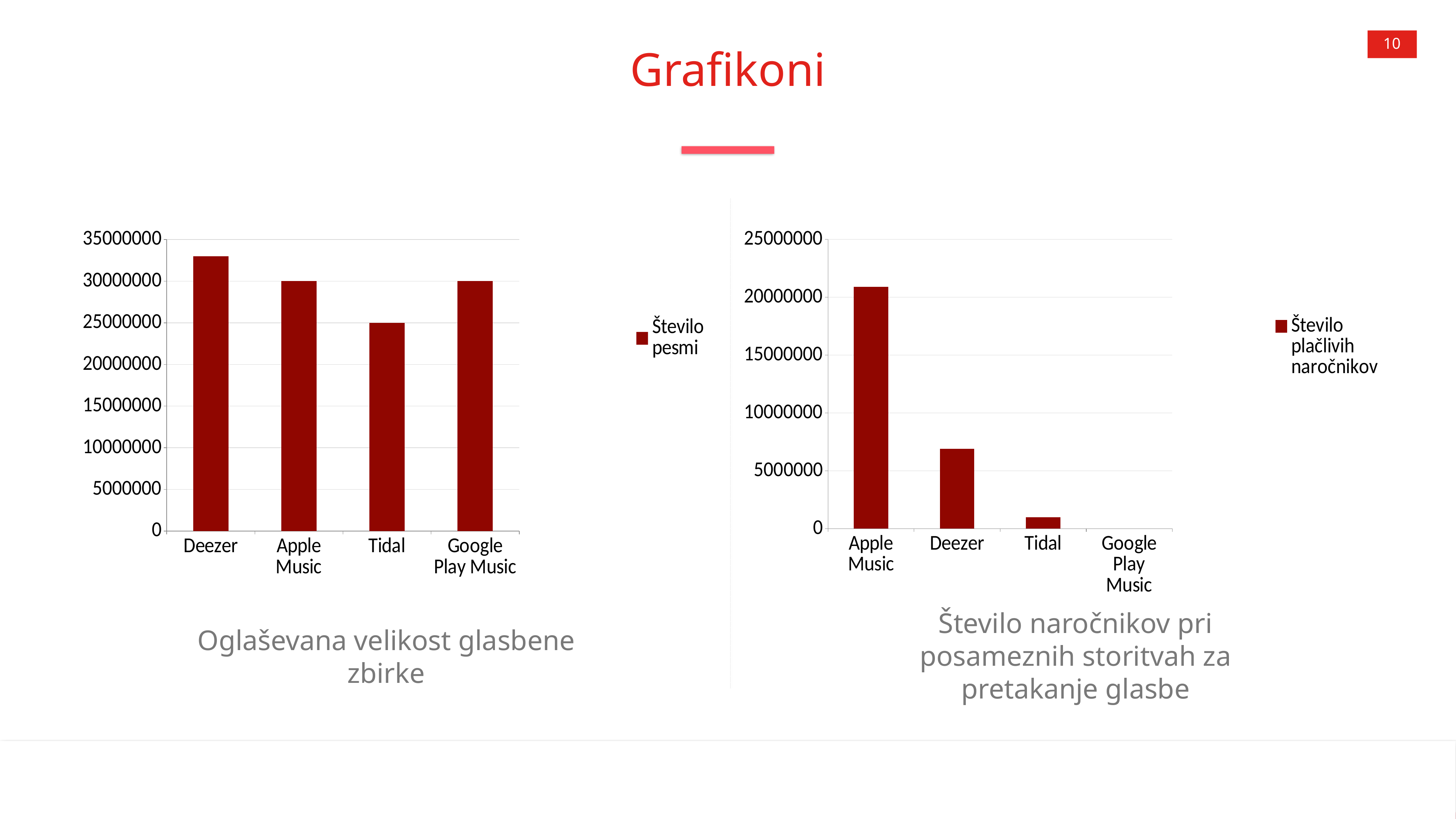
How many services are shown on the right chart (Število naročnikov pri posameznih storitvah za pretakanje glasbe)? 4 On the left chart (Oglaševana velikost glasbene zbirke), which service has the highest value? Deezer On the left chart (Oglaševana velikost glasbene zbirke), what is the value for Apple Music? 30000000 On the right chart (Število naročnikov pri posameznih storitvah za pretakanje glasbe), which is larger, the value for Deezer or the value for Tidal? Deezer What kind of chart is the left chart (Oglaševana velikost glasbene zbirke)? bar chart On the right chart (Število naročnikov pri posameznih storitvah za pretakanje glasbe), is the value for Deezer greater or less than 10000000? less On the left chart (Oglaševana velikost glasbene zbirke), which service has the lowest value? Tidal On the right chart (Število naročnikov pri posameznih storitvah za pretakanje glasbe), is the value for Apple Music greater or less than 20000000? greater On the left chart (Oglaševana velikost glasbene zbirke), what is the value for Tidal? 25000000 On the left chart (Oglaševana velikost glasbene zbirke), what is the difference between the values for Apple Music and Tidal? 5000000 On the left chart (Oglaševana velikost glasbene zbirke), is the value for Deezer greater or less than 30000000? greater On the right chart (Število naročnikov pri posameznih storitvah za pretakanje glasbe), which service has the highest value? Apple Music